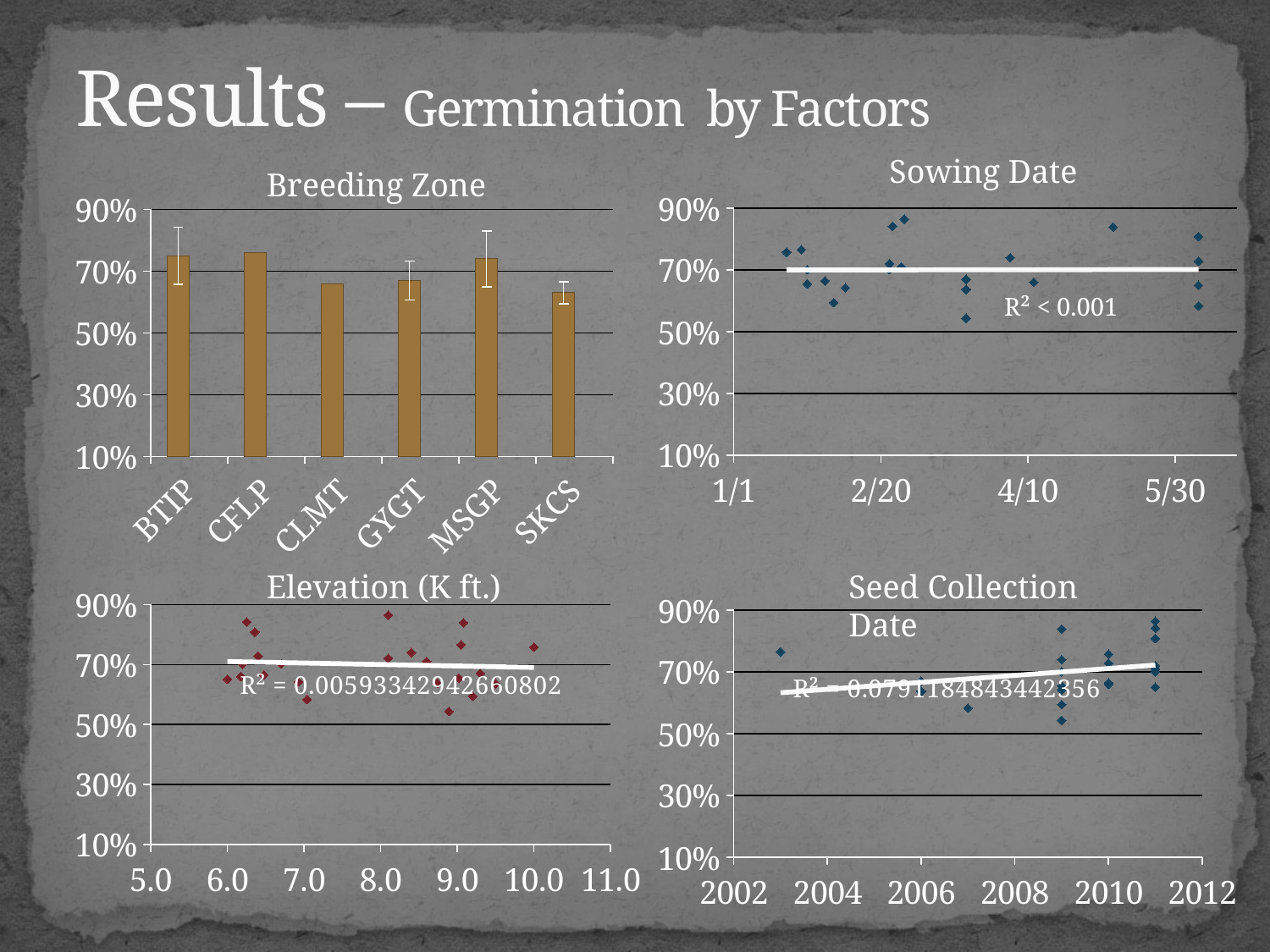
What R² value is printed on the Sowing Date chart? R² < 0.001 What kind of chart is the Breeding Zone chart? bar chart In the Breeding Zone chart, is the value for SKCS greater or less than 70%? less In the Breeding Zone chart, is the value for BTIP greater or less than 70%? greater What kind of chart is the Sowing Date chart? scatter chart In the Breeding Zone chart, which is larger, the value for BTIP or the value for CLMT? BTIP What R² value is printed on the Elevation (K ft.) chart? R² = 0.00593342942660802 In the Breeding Zone chart, is the value for CFLP greater or less than 70%? greater In the Seed Collection Date chart, does the trend line rise or fall from 2002 to 2012? rise In the Breeding Zone chart, which is larger, the value for CFLP or the value for SKCS? CFLP How many breeding zones are shown on the x axis of the Breeding Zone chart? 6